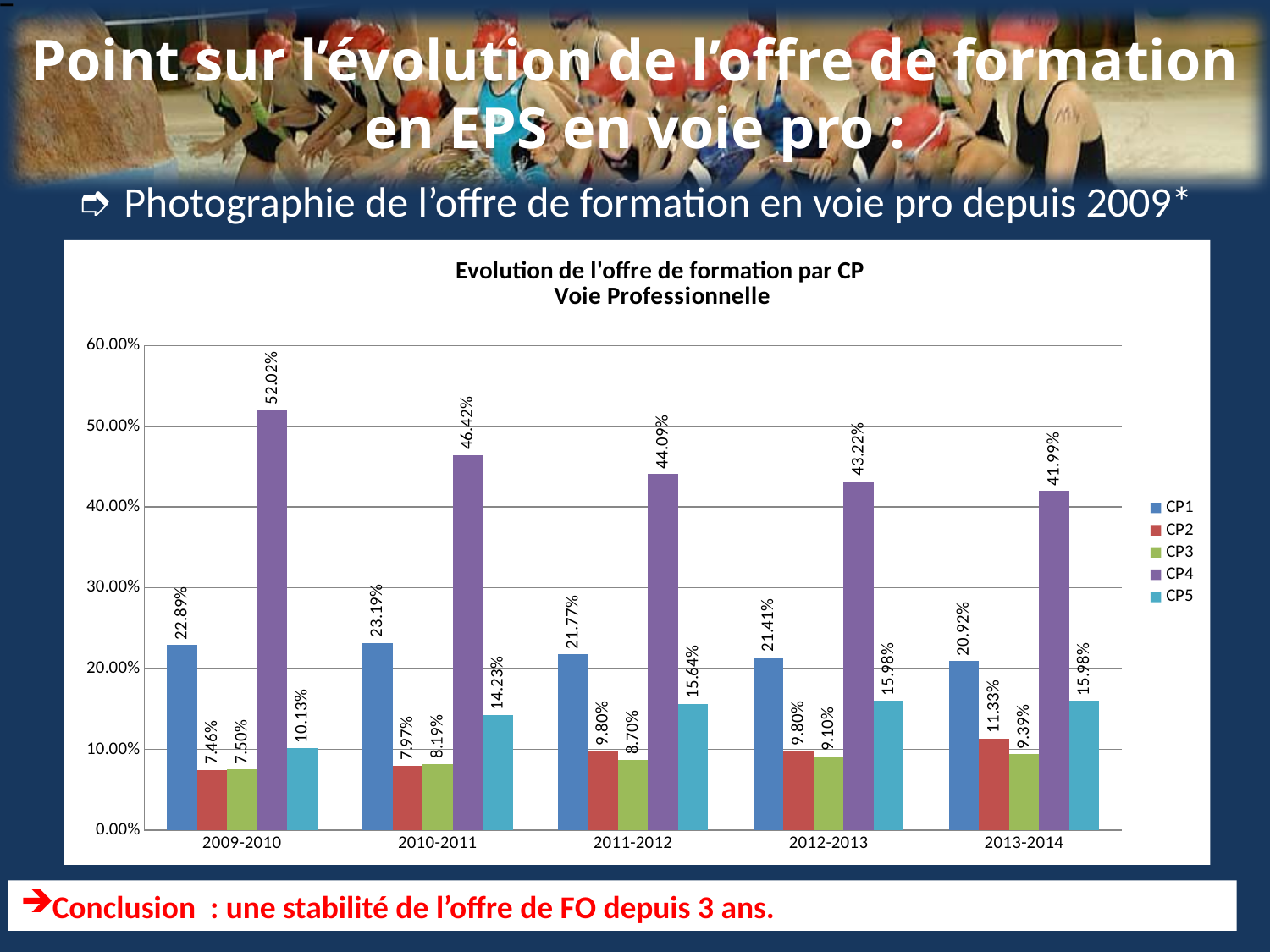
How many year categories are shown on the x axis? 5 In which year is the CP4 value highest? 2009-2010 What is the value for CP1 in 2013-2014? 20.92% What kind of chart is this? Bar chart What is the value for CP5 in 2011-2012? 15.64% What is the difference between the CP4 values in 2009-2010 and 2013-2014? 10.03% Does the CP4 value rise or fall from 2009-2010 to 2013-2014? Fall What is the value for CP4 in 2009-2010? 52.02% Which is larger in 2012-2013, CP1 or CP5? CP1 How many series does the legend list? 5 In which year is the CP5 value lowest? 2009-2010 What is the value for CP2 in 2010-2011? 7.97%